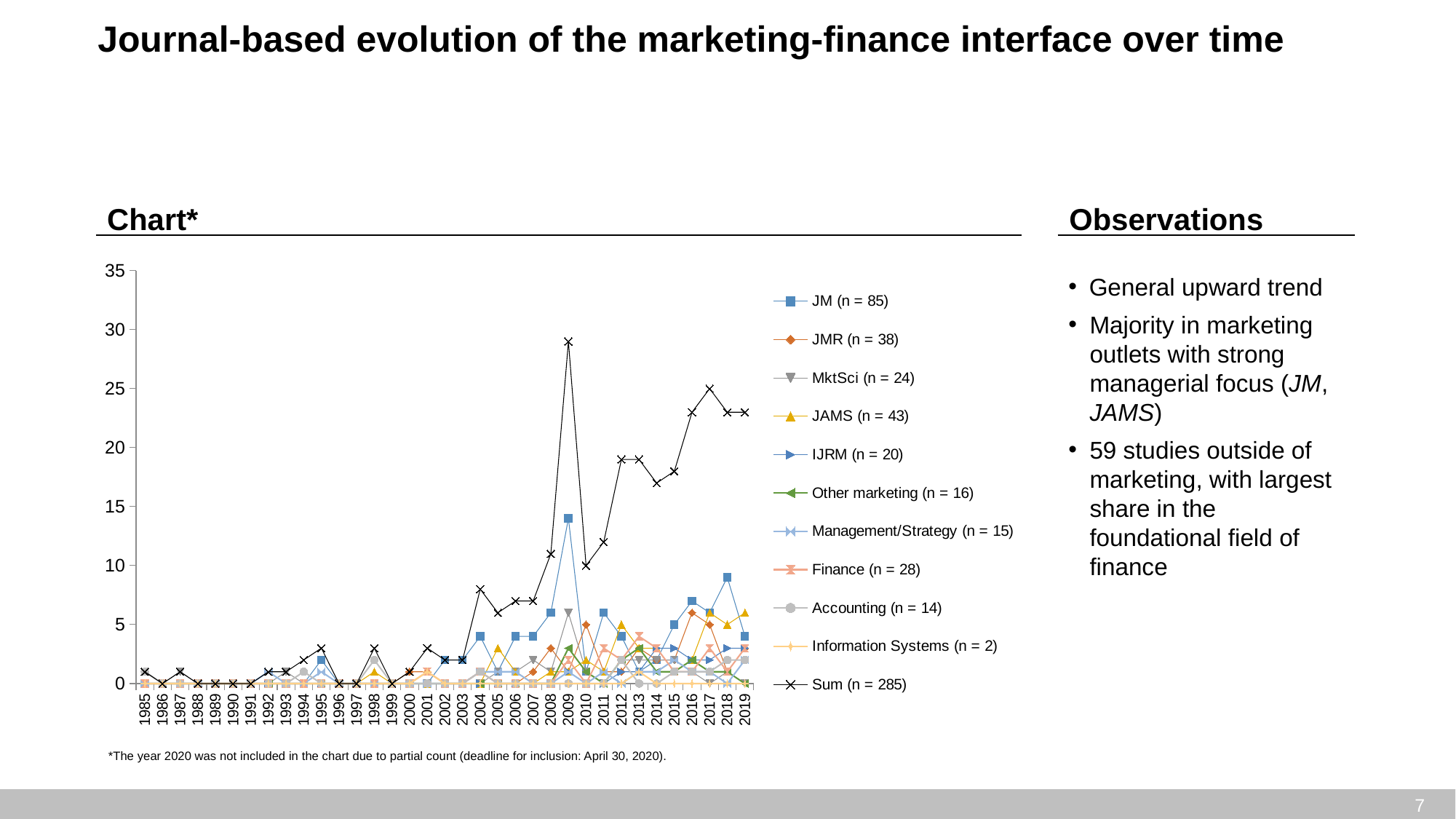
According to the legend, what is the n value for the Information Systems series? 2 Is the value of the Sum (n = 285) series in 2014 greater or less than 15? greater How many years are plotted along the x axis of the chart? 35 Is the value of the JM (n = 85) series in 2009 greater or less than 10? greater Is the value of the Sum (n = 285) series in 2009 greater or less than 25? greater Does the Sum (n = 285) series generally rise or fall from 1985 to 2019? Rise Which is larger: the Sum (n = 285) value in 2009 or in 2017? 2009 In which year does the Sum (n = 285) series reach its highest value? 2009 Which is larger in 2018: the JM (n = 85) value or the JAMS (n = 43) value? JM (n = 85) How many series does the chart's legend list? 11 What kind of chart is shown on the slide? Line chart